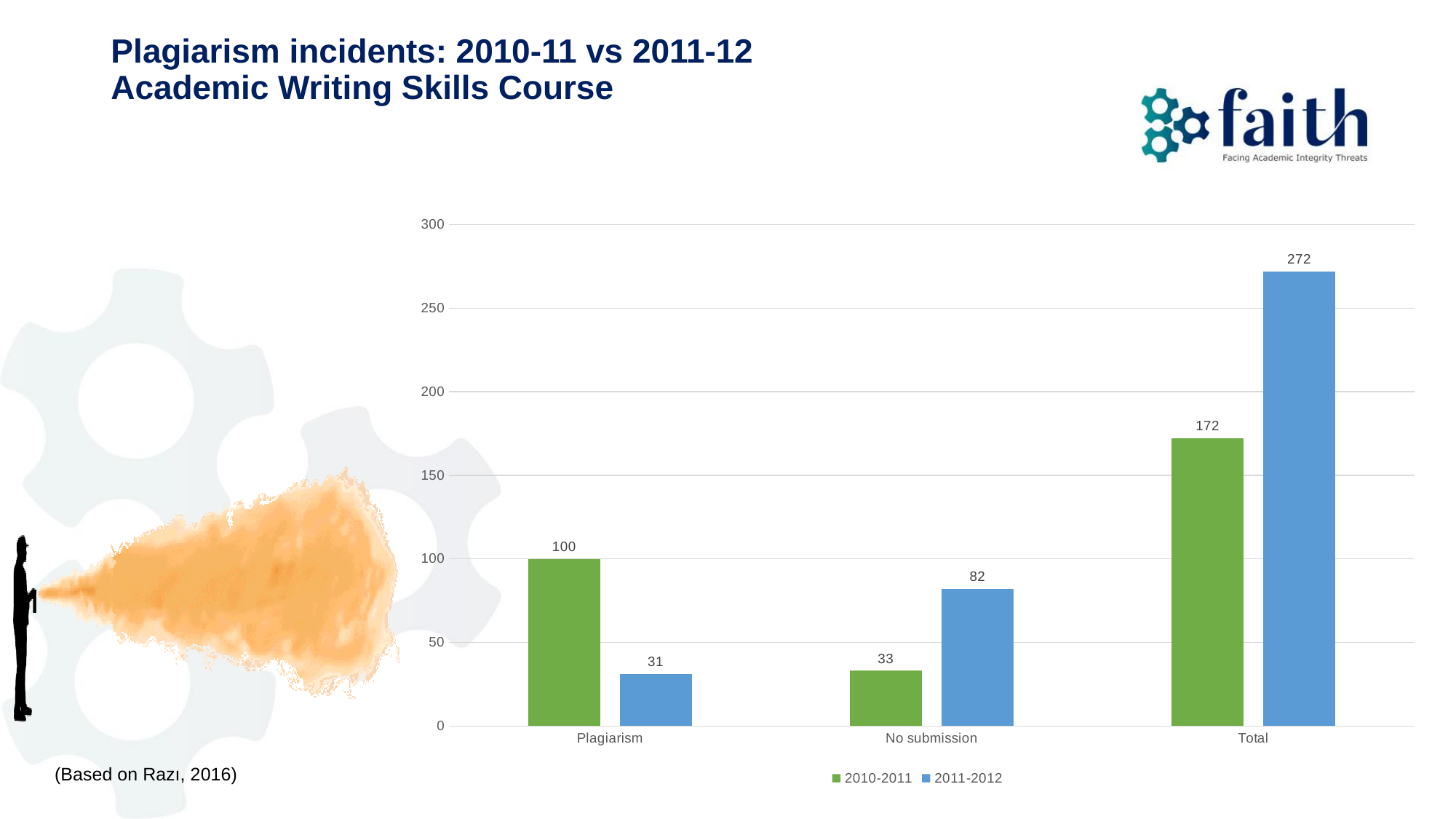
What is the value for Plagiarism in the 2010-2011 series? 100 What is the difference between the 2010-2011 and 2011-2012 values for Plagiarism? 69 Which category has the lowest value in the 2011-2012 series? Plagiarism What is the value for Total in the 2011-2012 series? 272 Which category has the highest value in the 2010-2011 series? Total What is the difference between the 2011-2012 and 2010-2011 values for Total? 100 How many categories are shown on the x axis? 3 How many series does the legend list? 2 Which is larger for No submission: the 2010-2011 value or the 2011-2012 value? 2011-2012 What is the value for Plagiarism in the 2011-2012 series? 31 What is the value for No submission in the 2011-2012 series? 82 What kind of chart is shown on the slide? Bar chart